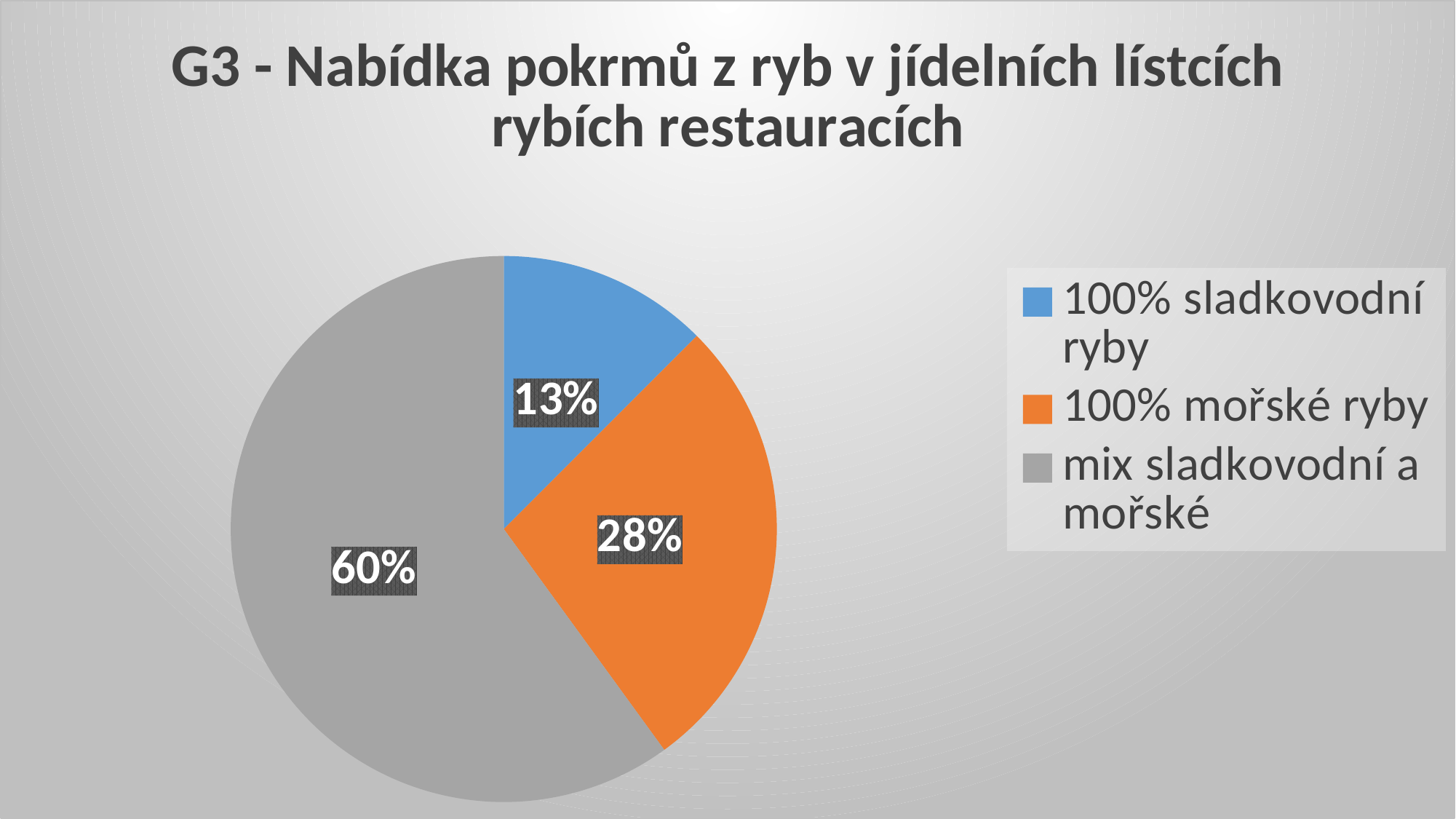
How many slices does the pie chart have? 3 What is the difference in percentage points between the "100% mořské ryby" slice and the "100% sladkovodní ryby" slice? 15 What share of the pie is labelled for "mix sladkovodní a mořské"? 60% Which category has the smallest slice of the pie? 100% sladkovodní ryby What share of the pie is labelled for "100% mořské ryby"? 28% How many entries does the legend list? 3 What share of the pie is labelled for "100% sladkovodní ryby"? 13% What kind of chart is shown on the slide? pie chart Which is larger: the slice for "100% mořské ryby" or the slice for "100% sladkovodní ryby"? 100% mořské ryby What colour is the slice for "100% mořské ryby"? orange Which category has the largest slice of the pie? mix sladkovodní a mořské What is the difference in percentage points between the "mix sladkovodní a mořské" slice and the "100% mořské ryby" slice? 32